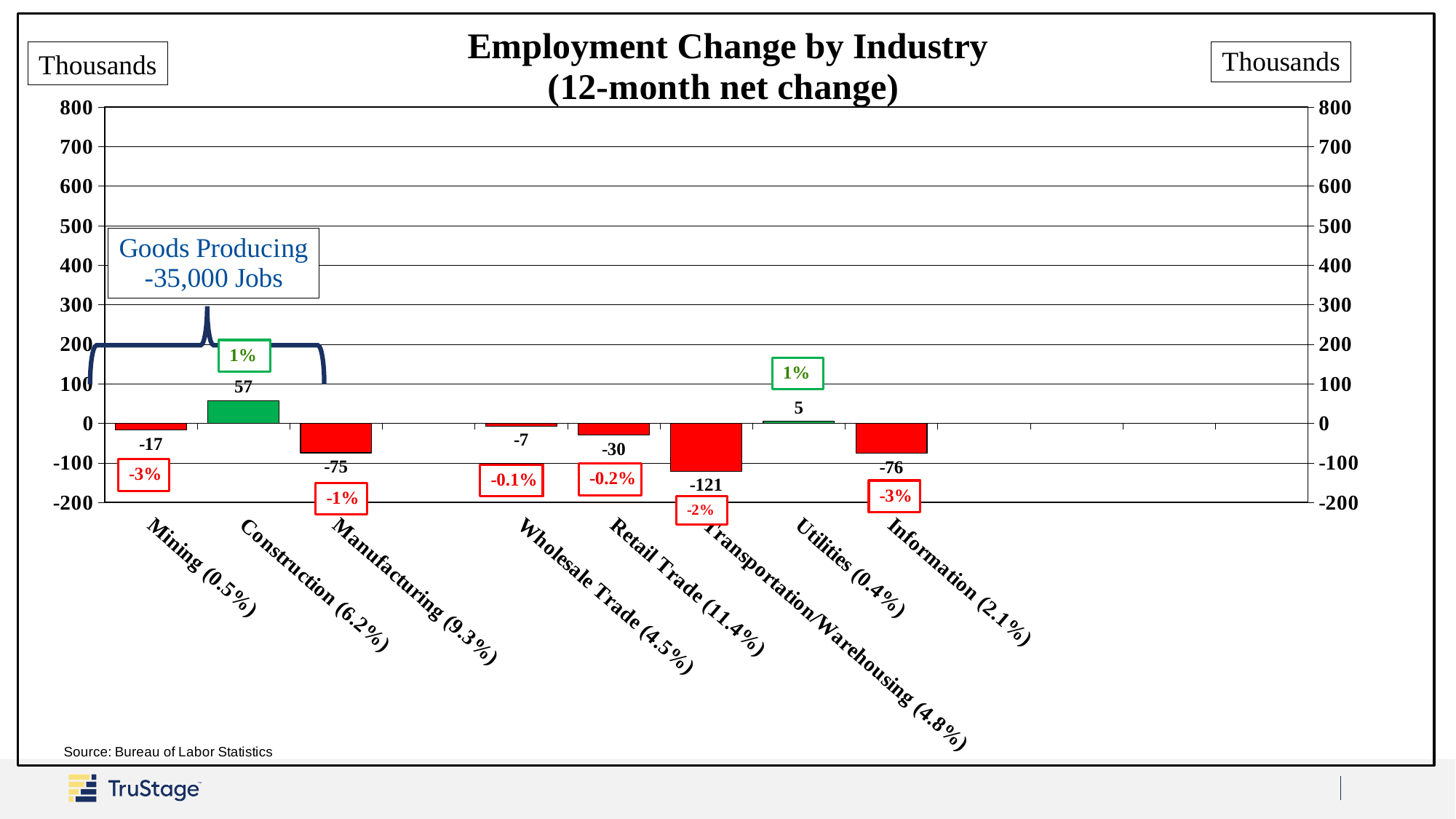
According to the callout box, what is the total job change for Goods Producing industries? -35,000 Jobs How many industries are labeled on the x axis of the chart? 8 What kind of chart is shown on the slide? Bar chart What is the 12-month net employment change for Transportation/Warehousing, in thousands? -121 Which industry has a larger net employment loss, Mining or Wholesale Trade? Mining What percentage change is shown in the box above the Construction bar? 1% What is the 12-month net employment change for Construction, in thousands? 57 What is the 12-month net employment change for Information, in thousands? -76 Which industry has the largest 12-month net employment loss? Transportation/Warehousing What is the 12-month net employment change for Utilities, in thousands? 5 Which industry has the largest 12-month net employment gain? Construction What is the difference between the net employment change for Manufacturing and for Retail Trade, in thousands? 45